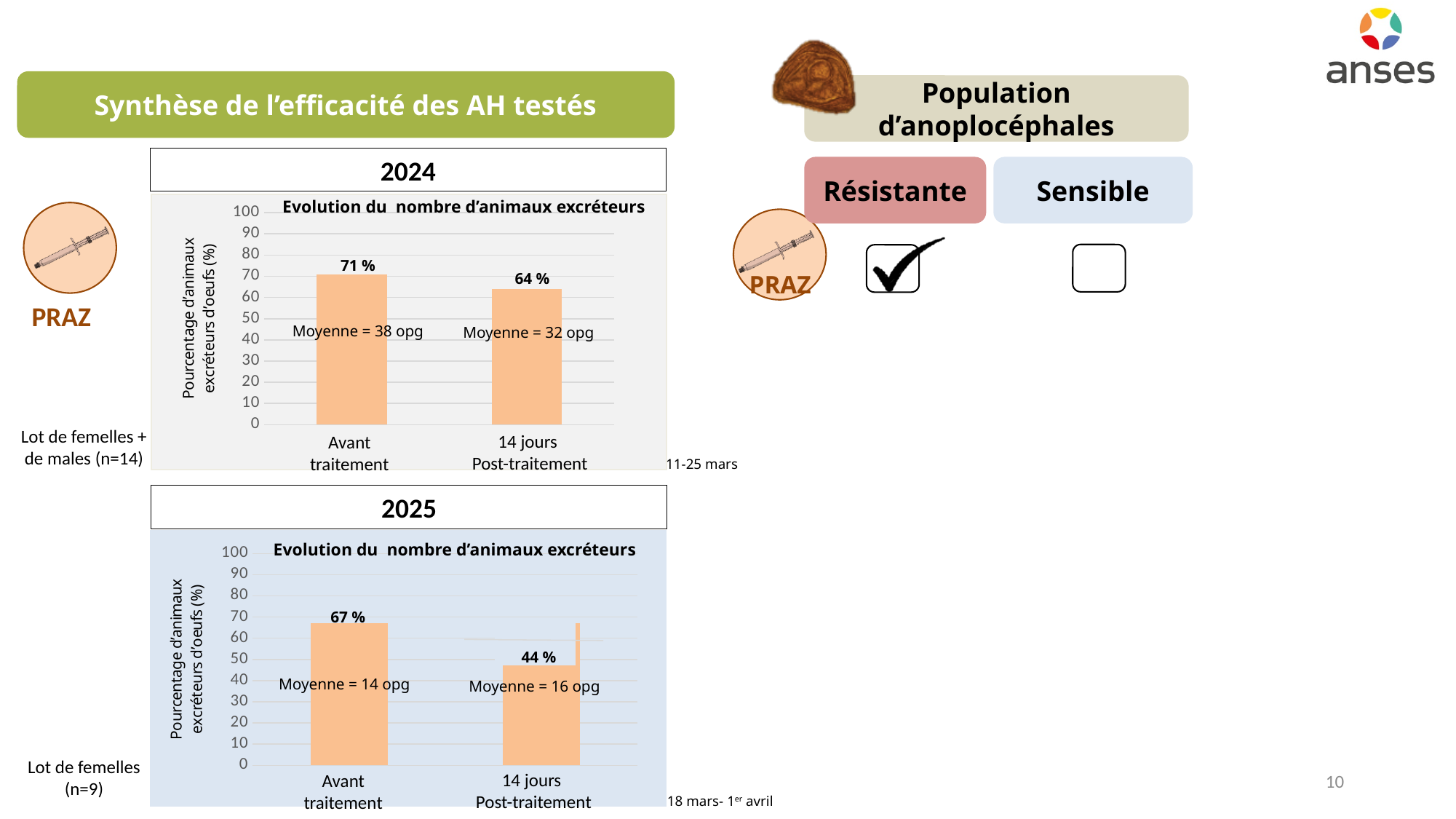
What kind of chart is the 2024 chart? bar chart How many categories are shown in the 2025 chart? 2 In the 2025 chart, what is the value for '14 jours Post-traitement'? 44 % In the 2025 chart, is the value for '14 jours Post-traitement' greater or less than 50? less In the 2024 chart, what is the value for '14 jours Post-traitement'? 64 % What is the title of the 2025 chart? Evolution du nombre d'animaux excréteurs In the 2024 chart, what is the value for 'Avant traitement'? 71 % In the 2024 chart, which category has the highest value? Avant traitement In the 2025 chart, which category has the lowest value? 14 jours Post-traitement In the 2024 chart, what is the difference between the 'Avant traitement' and '14 jours Post-traitement' values? 7 % In the 2025 chart, what is the value for 'Avant traitement'? 67 % In the 2025 chart, what is the difference between the 'Avant traitement' and '14 jours Post-traitement' values? 23 %